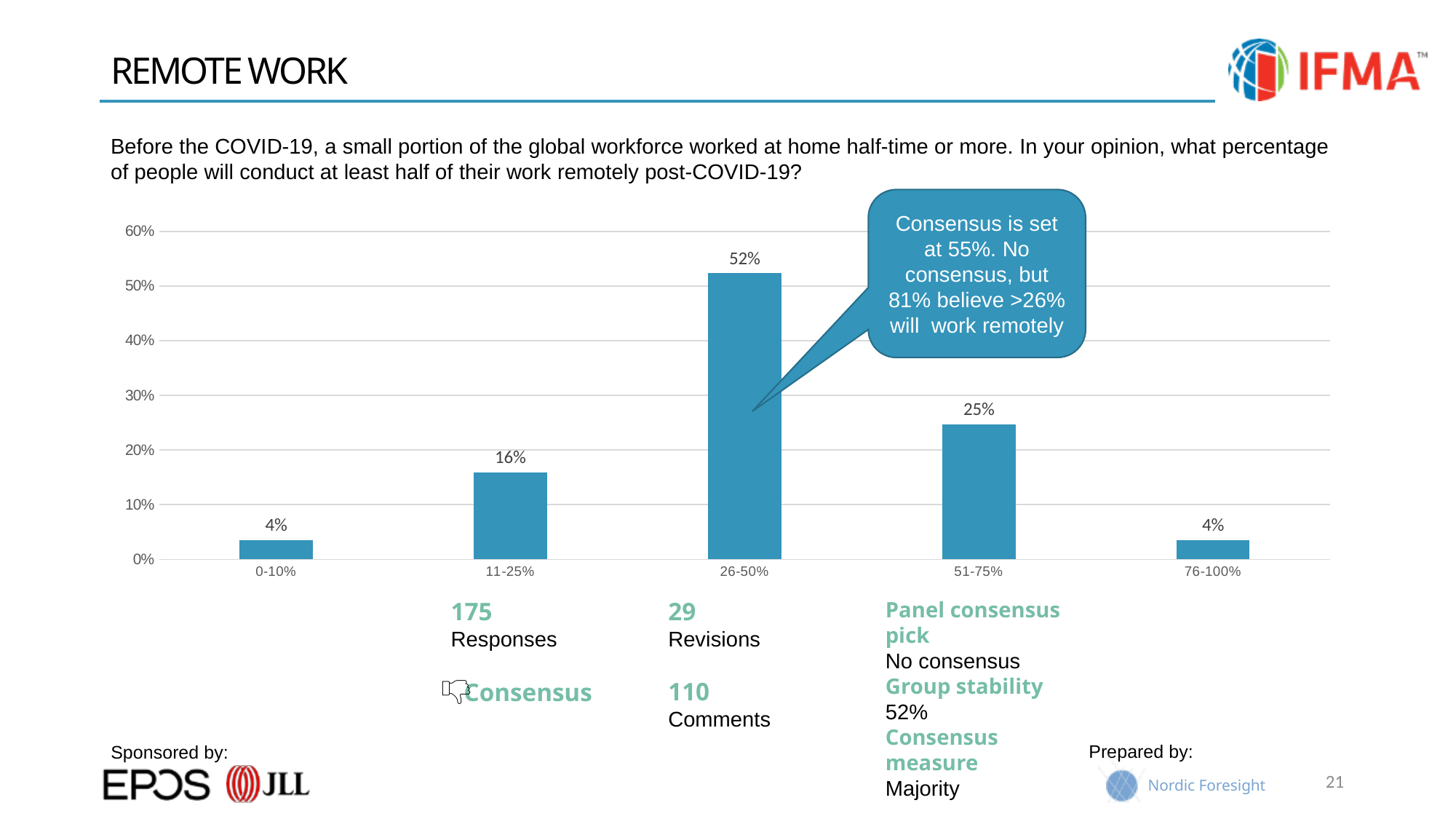
What is the difference between the values for 26-50% and 51-75%? 27% What is the difference between the values for 11-25% and 0-10%? 12% How many categories are shown on the x axis? 5 What value is shown for the 51-75% category? 25% What is the highest value shown on the y axis? 60% What kind of chart is shown on the slide? bar chart What value is shown for the 11-25% category? 16% Which is larger, the value for 11-25% or the value for 51-75%? 51-75% Which two categories share the same value of 4%? 0-10% and 76-100% Is the value for 26-50% greater or less than 50%? greater What percentage of respondents chose the 26-50% category? 52% Which category has the highest value? 26-50%